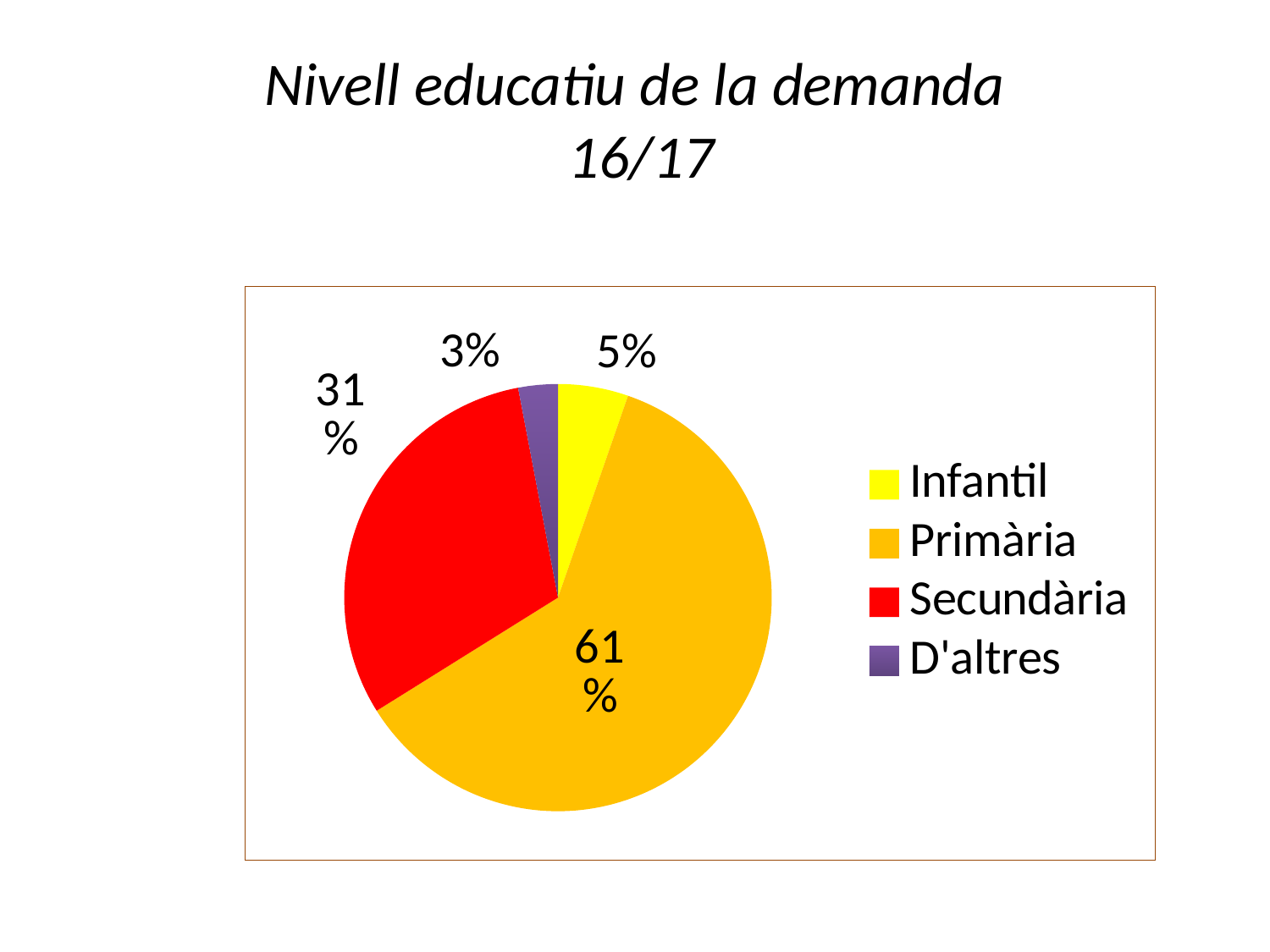
What share of the pie does Secundària have? 31% What share of the pie does Infantil have? 5% What is the title of the chart on the slide? Nivell educatiu de la demanda 16/17 Which category has the smallest slice of the pie? D'altres Which category has the largest slice of the pie? Primària What share of the pie does Primària have? 61% What is the difference in percentage points between Primària and Secundària? 30 What kind of chart is shown on the slide? pie chart Which is larger, the share for Infantil or the share for D'altres? Infantil How many categories does the pie chart show? 4 What colour is the slice for Secundària? red